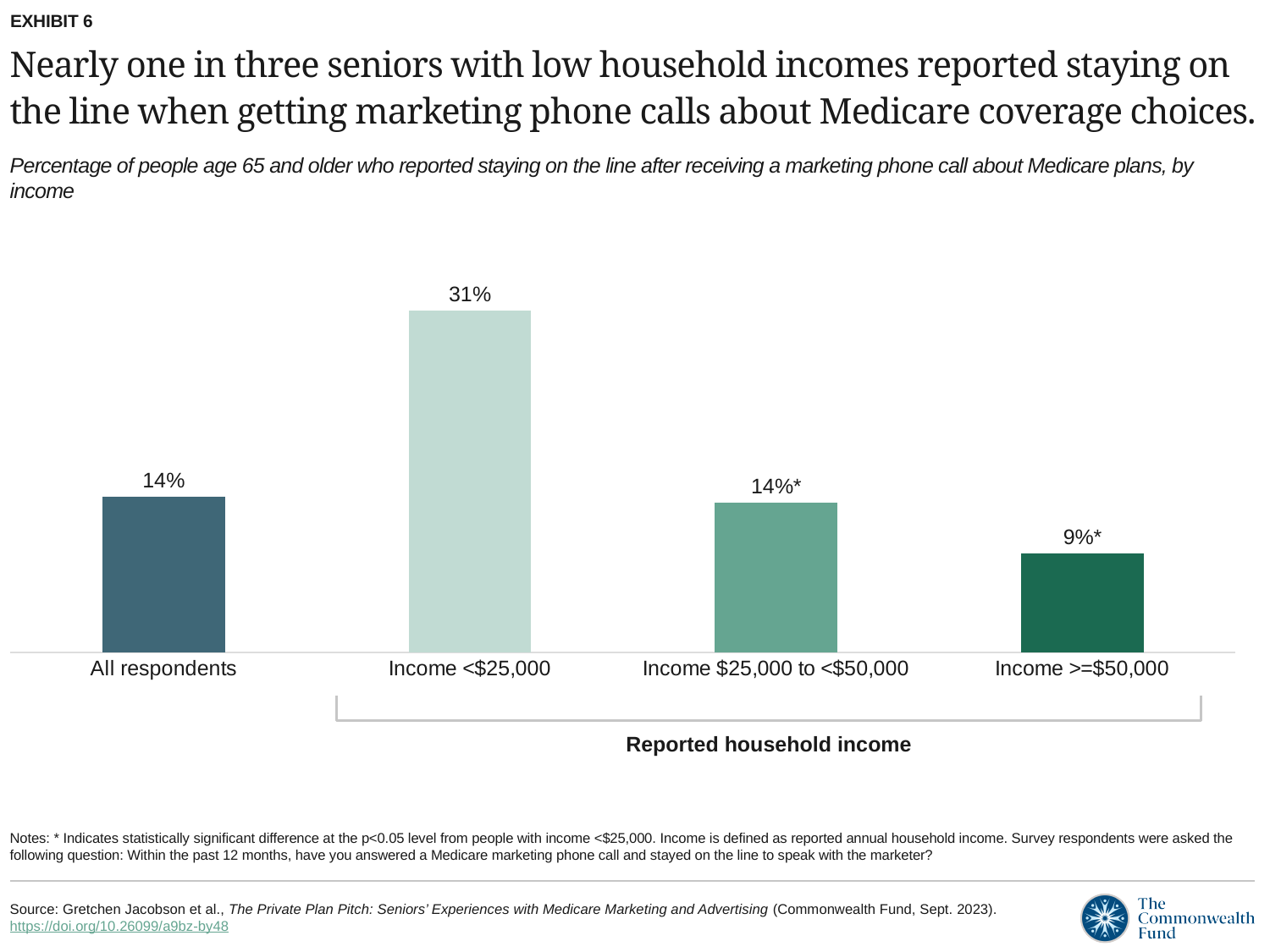
What is the difference in percentage points between the Income <$25,000 group and all respondents? 17 percentage points Which category has the highest percentage of people who reported staying on the line? Income <$25,000 Which is larger: the value for Income <$25,000 or the value for Income $25,000 to <$50,000? Income <$25,000 What percentage of people with income <$25,000 reported staying on the line? 31% What kind of chart is shown on the slide? Bar chart What is the difference in percentage points between the Income <$25,000 group and the Income >=$50,000 group? 22 percentage points What is the value shown for the Income >=$50,000 category? 9%* What is the value shown for the Income $25,000 to <$50,000 category? 14%* What percentage of all respondents reported staying on the line after receiving a marketing phone call about Medicare plans? 14% How many categories are shown in the chart? 4 What label appears under the bracket grouping the three income categories? Reported household income Which category has the lowest percentage of people who reported staying on the line? Income >=$50,000